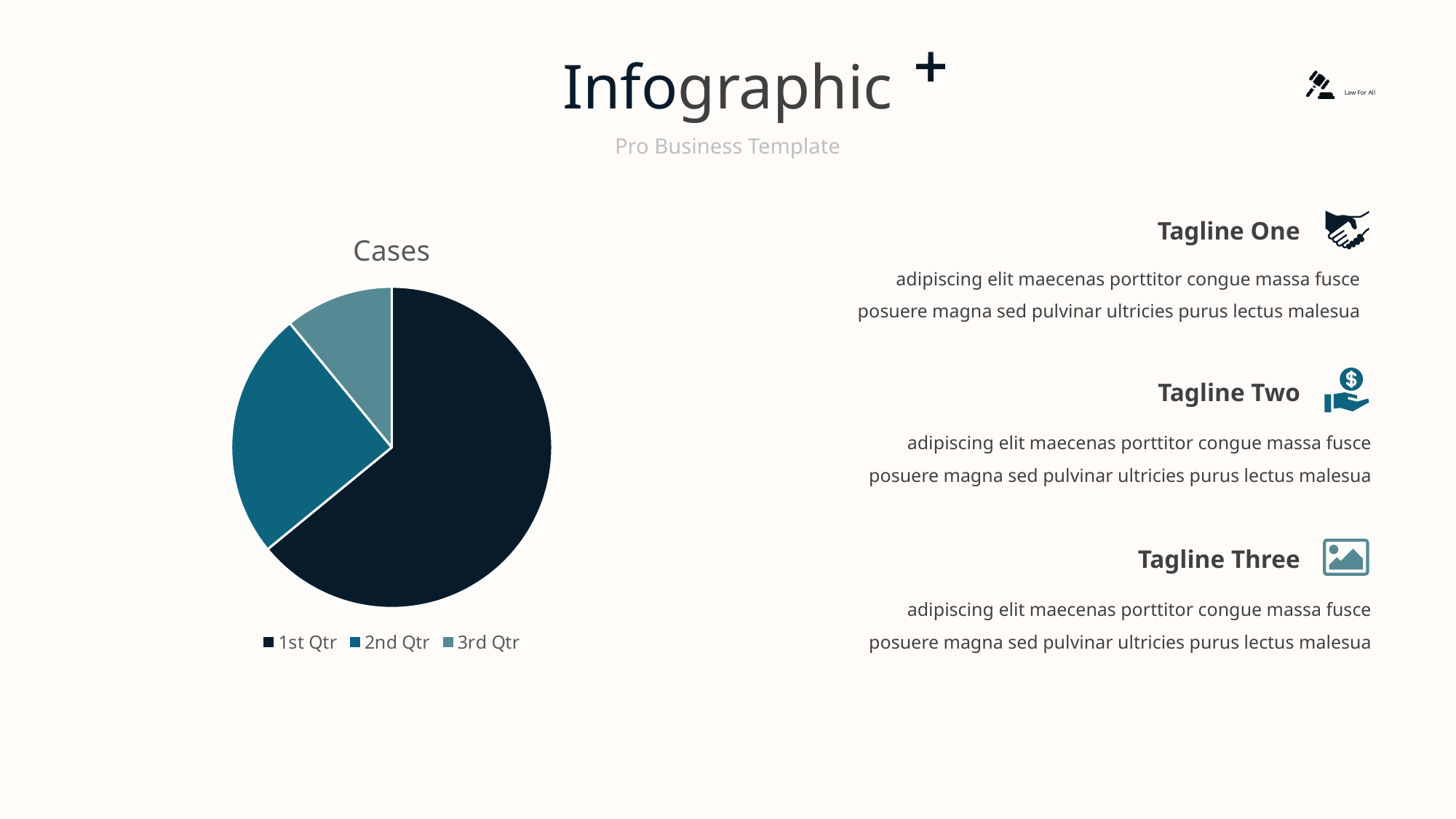
Does the 1st Qtr slice take up more or less than half of the pie chart? more Which category has the smallest slice in the pie chart? 3rd Qtr How many entries does the legend of the pie chart list? 3 What is the title of the pie chart? Cases Which legend entry is shown in the darkest colour in the pie chart? 1st Qtr Which category has the largest slice in the pie chart? 1st Qtr Which slice is larger in the pie chart, 2nd Qtr or 3rd Qtr? 2nd Qtr What kind of chart is shown on the slide? Pie chart How many slices does the pie chart have? 3 Which slice is larger in the pie chart, 1st Qtr or 2nd Qtr? 1st Qtr